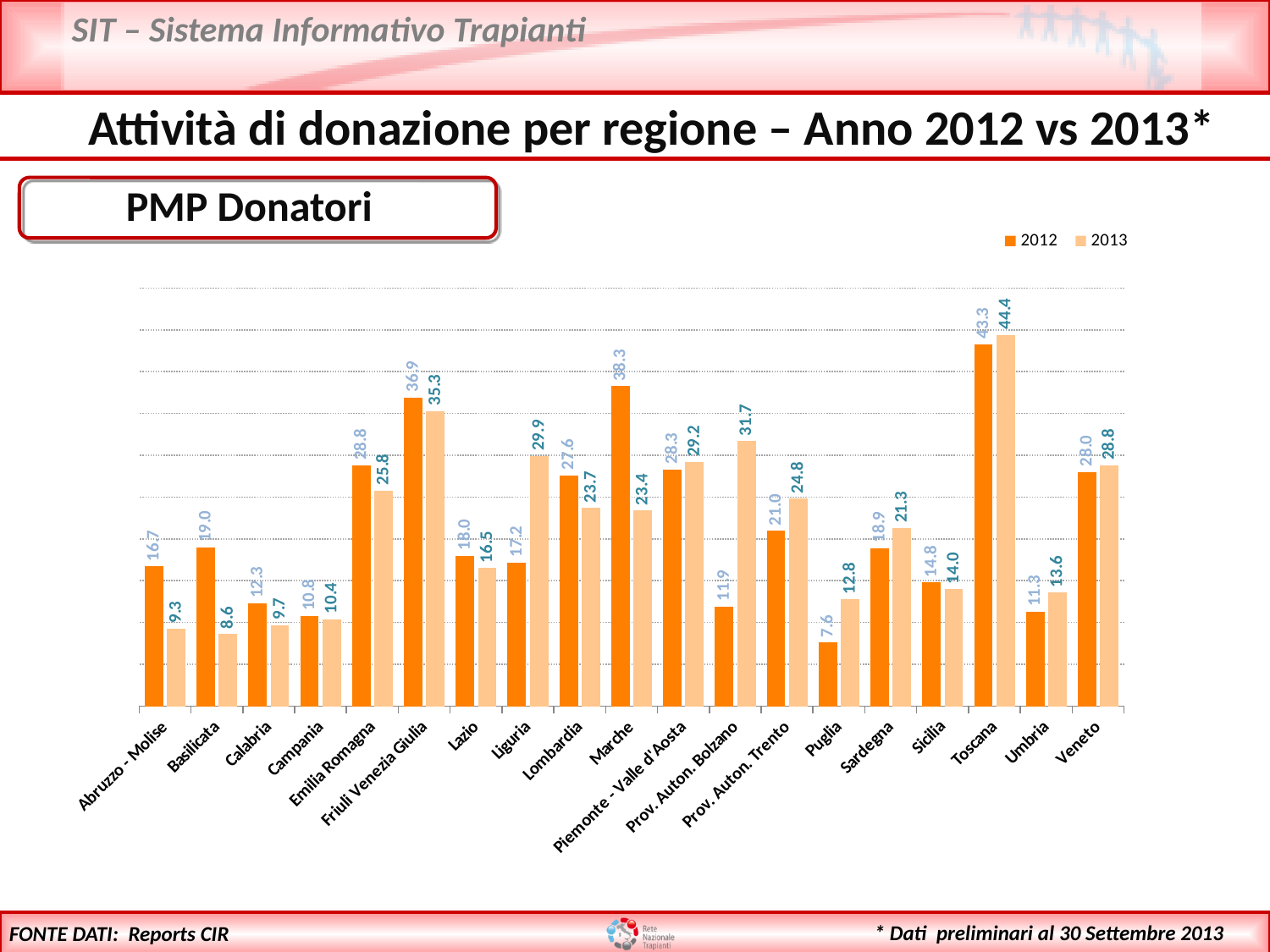
What is the 2012 value for Toscana? 43.3 How many series does the legend list? 2 Which is larger for Liguria, the 2012 value or the 2013 value? 2013 How many regions are shown on the x axis? 19 Which region has the lowest 2013 value? Basilicata What is the 2012 value for Marche? 38.3 What is the title shown in the box above the chart? PMP Donatori What is the 2013 value for Prov. Auton. Bolzano? 31.7 Which region has the highest 2013 value? Toscana Which region has the lowest 2012 value? Puglia What kind of chart is shown? Bar chart What is the difference between the 2012 and 2013 values for Marche? 14.9